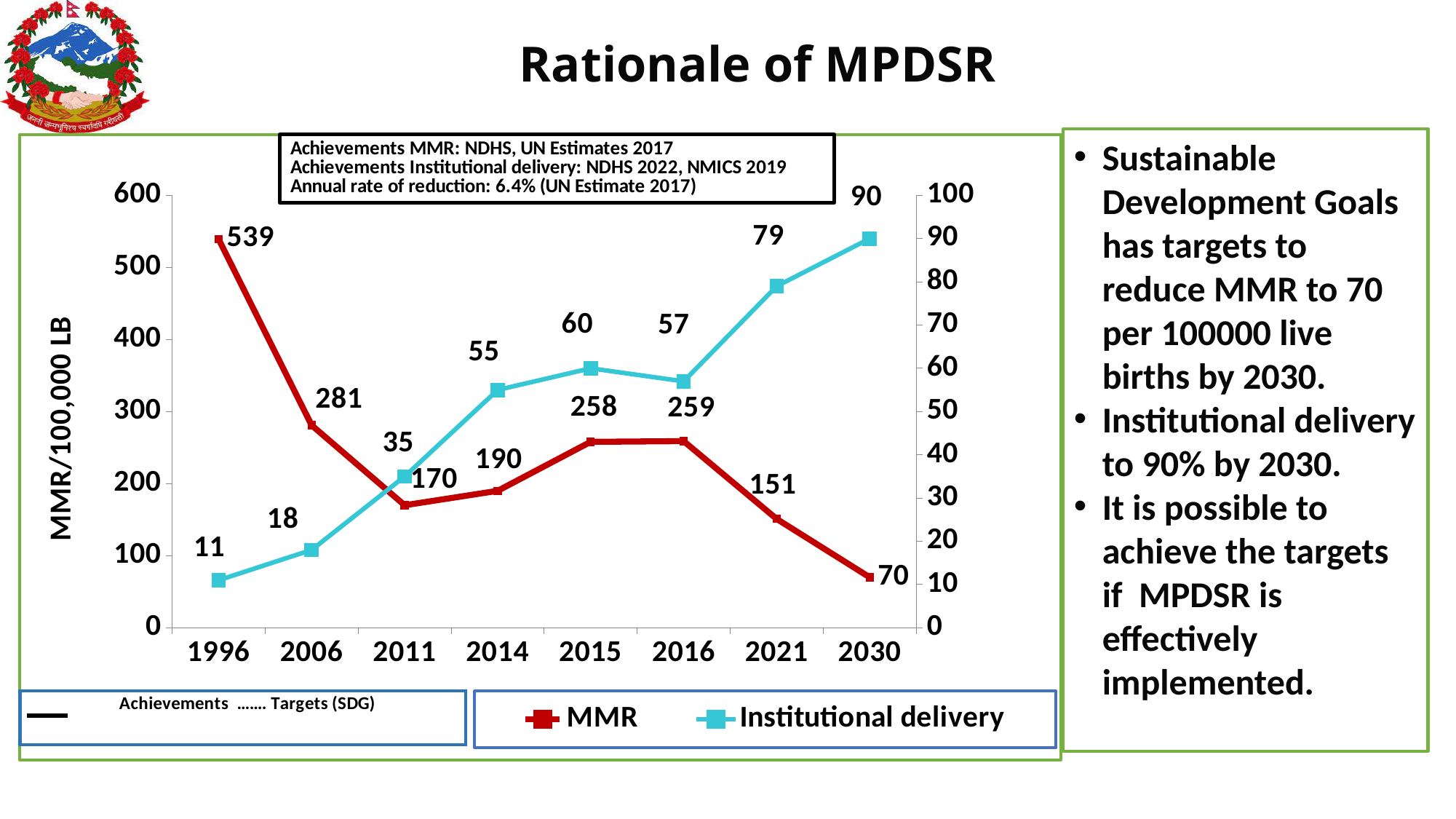
How many series does the legend list? 2 What is the difference between the MMR values for 2006 and 2011? 111 How many years are shown on the x axis? 8 Is the MMR value for 2021 greater or less than 200? less In which year is MMR highest? 1996 In which year is Institutional delivery lowest? 1996 Which is larger, the Institutional delivery value for 2015 or for 2016? 2015 What is the MMR value for 2030? 70 What kind of chart is shown? line chart Does the Institutional delivery series generally rise or fall from 1996 to 2030? rise What is the Institutional delivery value for 2021? 79 What is the MMR value for 1996? 539